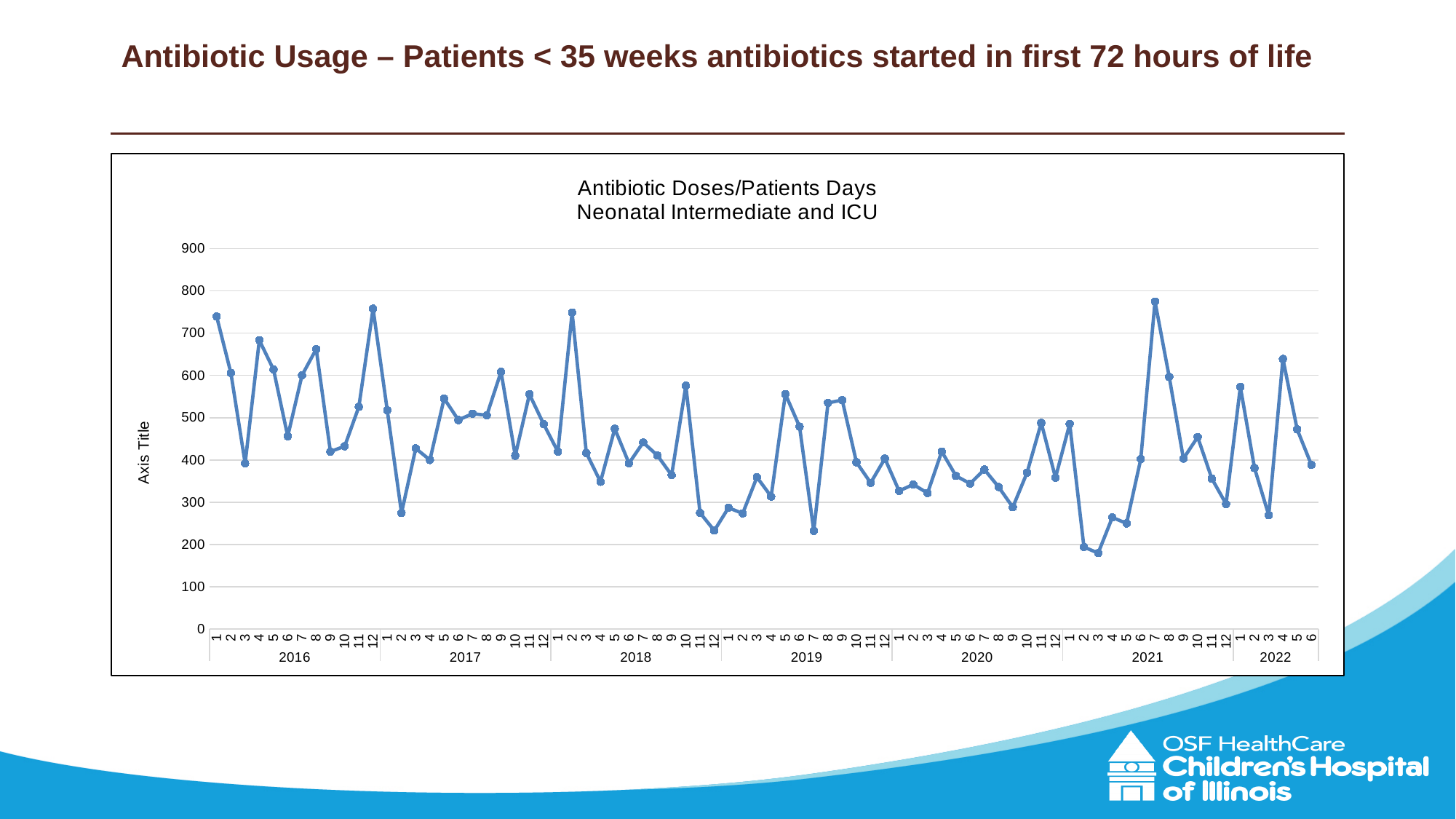
Is the value for month 2 of 2018 greater or less than 700? greater What label is shown on the vertical axis of the chart? Axis Title Is the value for month 2 of 2017 greater or less than 300? less Is the value for month 7 of 2019 greater or less than 300? less How many monthly data points are plotted in the chart (2016 month 1 through 2022 month 6)? 78 How many years are labelled along the x axis of the chart? 7 What kind of chart is shown on the slide? line chart Do the values rise or fall from month 3 to month 7 of 2021? rise What is the title of the chart? Antibiotic Doses/Patients Days Neonatal Intermediate and ICU